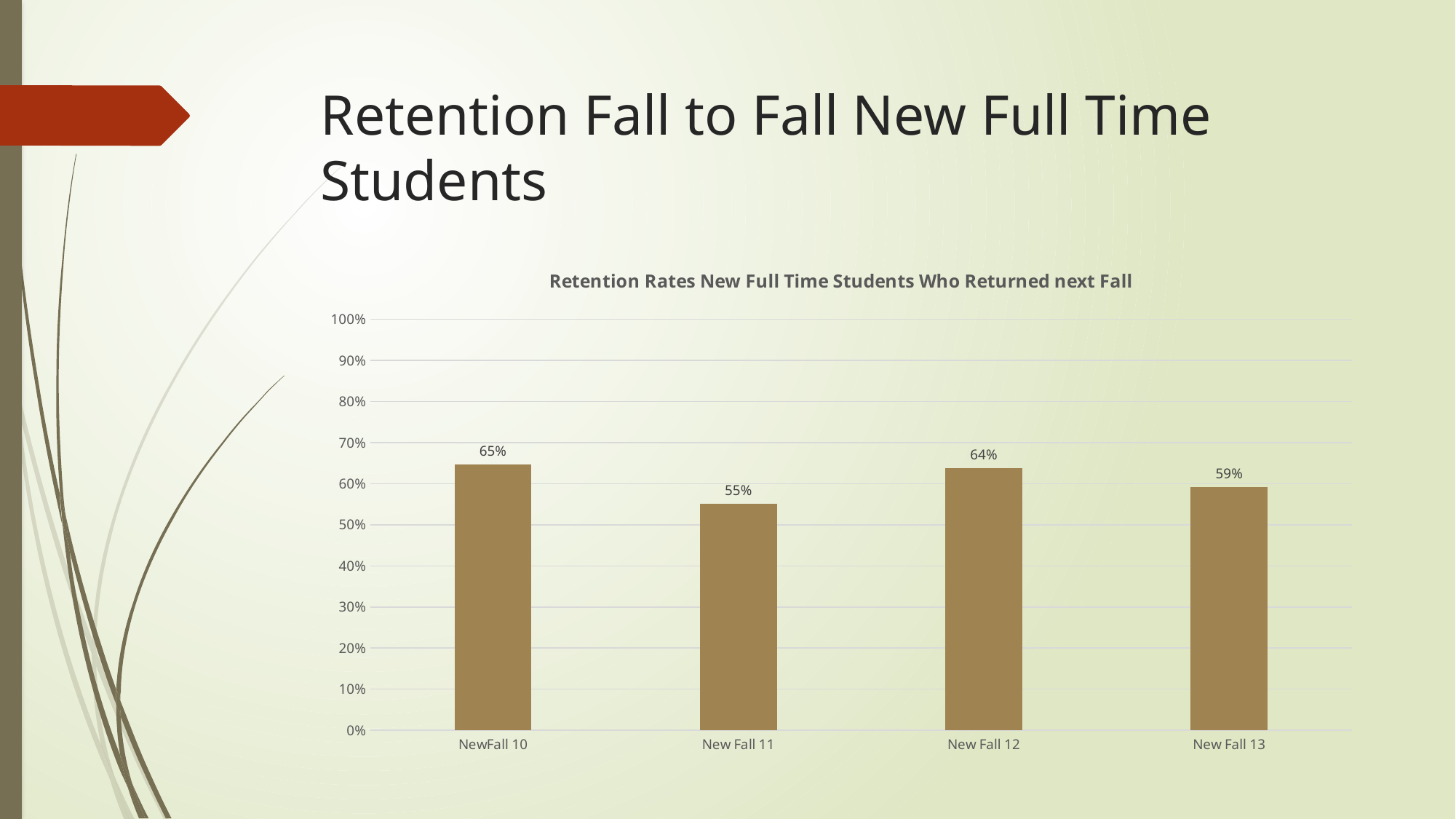
Which has a higher retention rate, New Fall 12 or New Fall 13? New Fall 12 Is the retention rate for New Fall 11 greater or less than 60%? less What is the difference in retention rate between NewFall 10 and New Fall 11? 10% What is the retention rate for New Fall 13? 59% What is the difference in retention rate between New Fall 12 and New Fall 13? 5% What kind of chart is shown on the slide? bar chart How many cohorts are shown in the chart? 4 What is the retention rate for NewFall 10? 65% Which cohort has the highest retention rate? NewFall 10 Which cohort has the lowest retention rate? New Fall 11 What is the retention rate for New Fall 11? 55% What is the title of the chart? Retention Rates New Full Time Students Who Returned next Fall